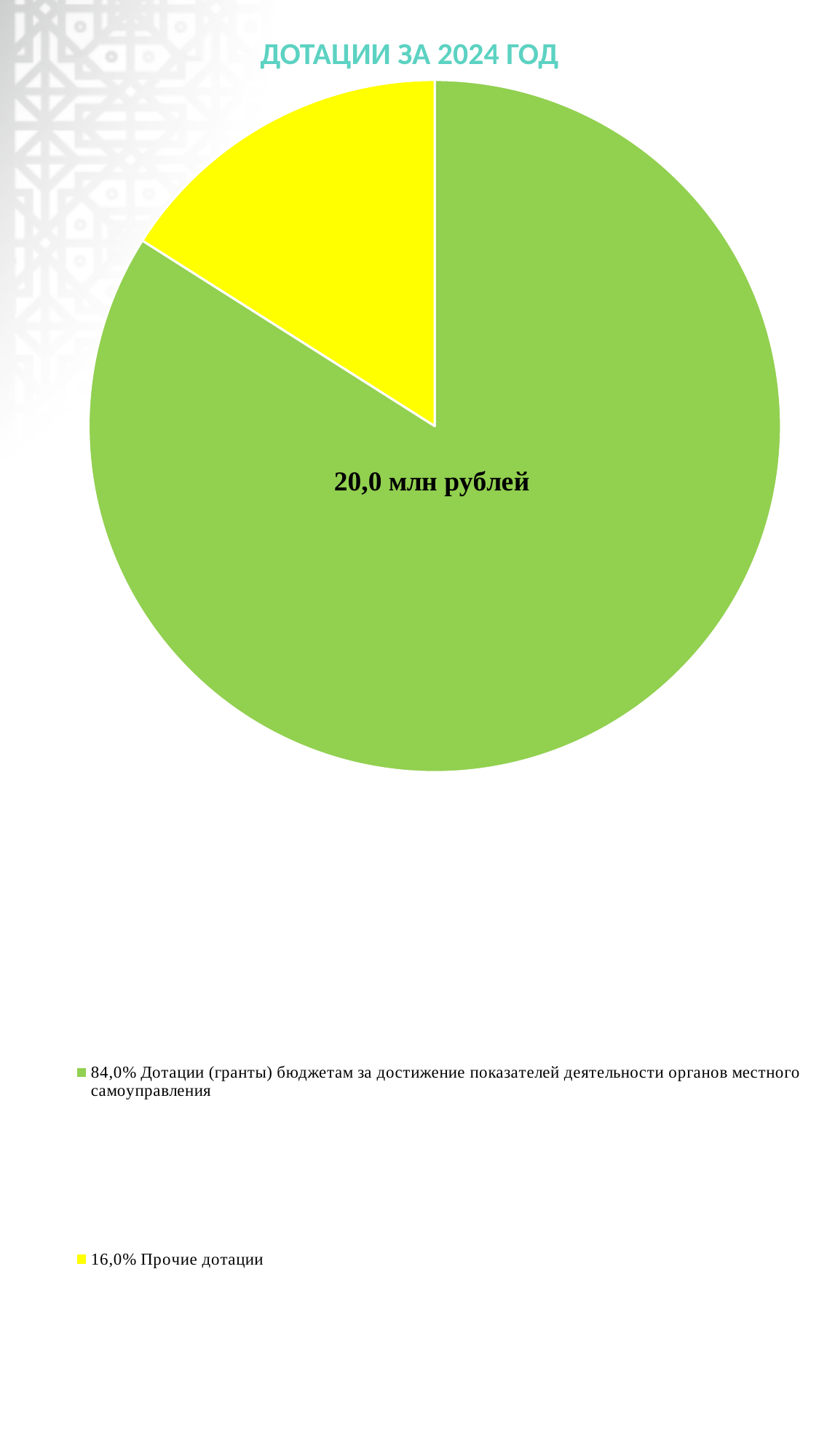
What is the difference in percentage points between the two slices? 68,0% Which is larger: 'Прочие дотации' or 'Дотации (гранты) бюджетам за достижение показателей деятельности органов местного самоуправления'? Дотации (гранты) бюджетам за достижение показателей деятельности органов местного самоуправления What share of the pie is 'Дотации (гранты) бюджетам за достижение показателей деятельности органов местного самоуправления'? 84,0% How many slices does the pie chart have? 2 Which slice is the smallest? Прочие дотации What colour is the 'Прочие дотации' slice? yellow Which slice is the largest? Дотации (гранты) бюджетам за достижение показателей деятельности органов местного самоуправления What total amount is printed on the pie chart? 20,0 млн рублей What share of the pie is 'Прочие дотации'? 16,0% What is the title of the chart? ДОТАЦИИ ЗА 2024 ГОД What type of chart is shown on the slide? pie chart